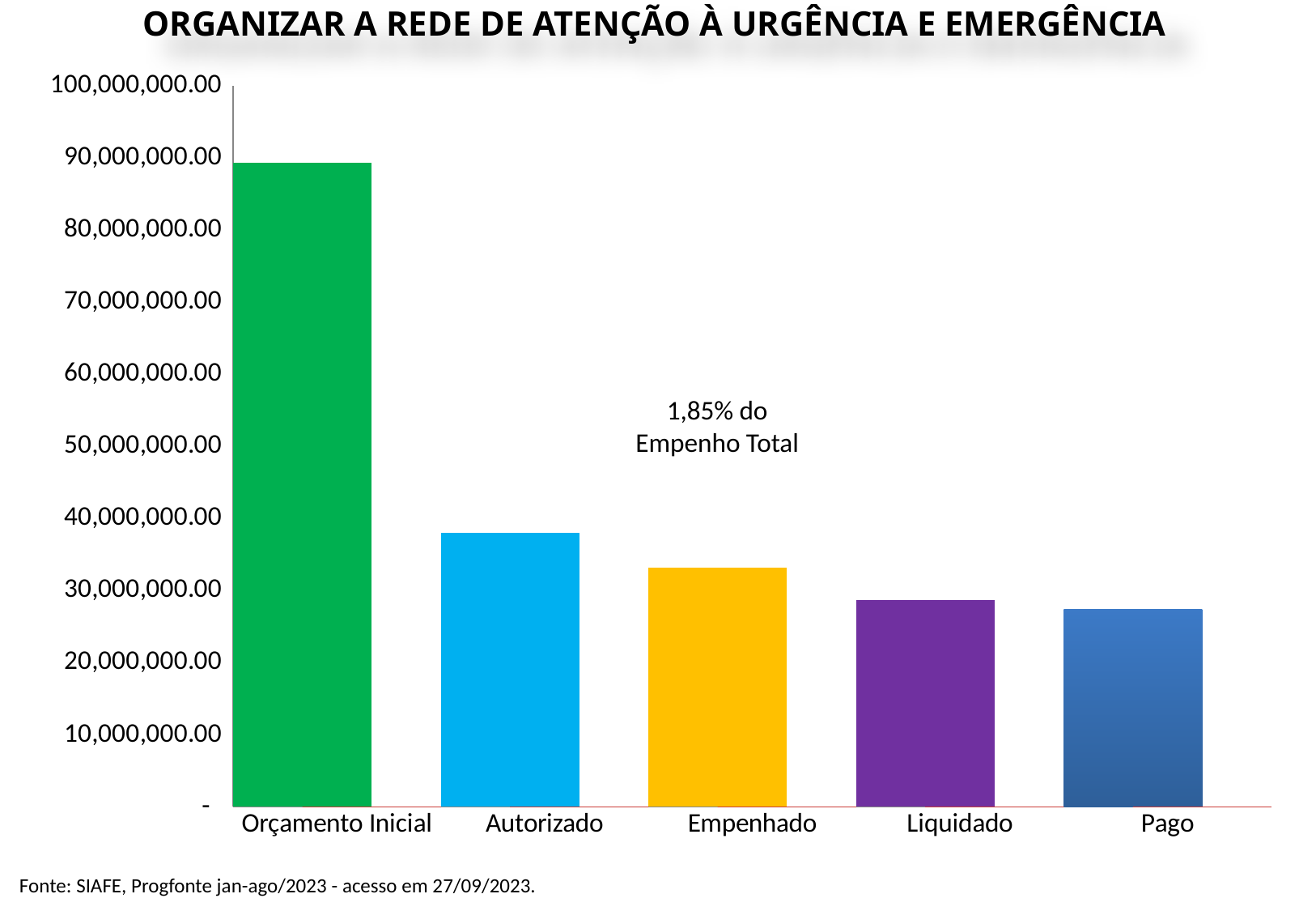
Which category has the highest value? Orçamento Inicial Is the value for Orçamento Inicial greater or less than 80,000,000.00? greater Is the value for Pago greater or less than 20,000,000.00? greater Do the values rise or fall from left to right across the categories? fall Is the value for Autorizado greater or less than 40,000,000.00? less How many categories are plotted on the chart? 5 Which is larger, the value for Autorizado or the value for Empenhado? Autorizado What kind of chart is shown on the slide? bar chart What percentage of the Empenho Total does the annotation on the chart state? 1,85% What is the title of the chart? ORGANIZAR A REDE DE ATENÇÃO À URGÊNCIA E EMERGÊNCIA